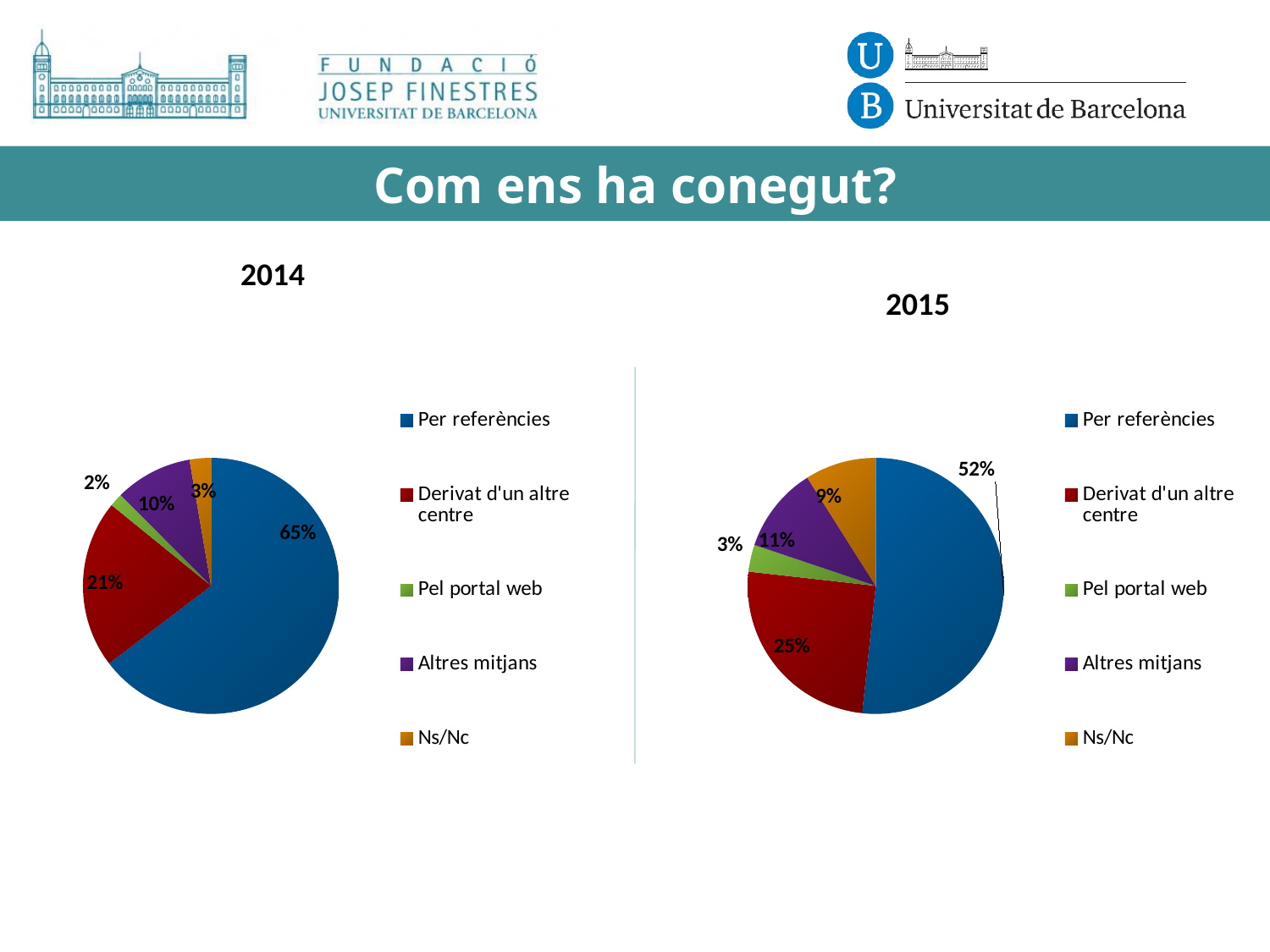
In the 2015 chart, what is the value for Derivat d'un altre centre? 25% What type of chart is used for the 2014 data? Pie chart In the 2014 chart, what is the difference between Per referències and Derivat d'un altre centre? 44% In the 2015 chart, what share does Per referències have? 52% In the 2015 chart, what is the value for Ns/Nc? 9% Which is larger in the 2015 chart: Altres mitjans or Ns/Nc? Altres mitjans In the 2014 chart, what is the value for Derivat d'un altre centre? 21% What is the title of the slide containing the two charts? Com ens ha conegut? In the 2015 chart, which category has the largest slice? Per referències In the 2014 chart, what share does Per referències have? 65% How many categories does the 2015 chart show? 5 In the 2014 chart, which category has the smallest slice? Pel portal web